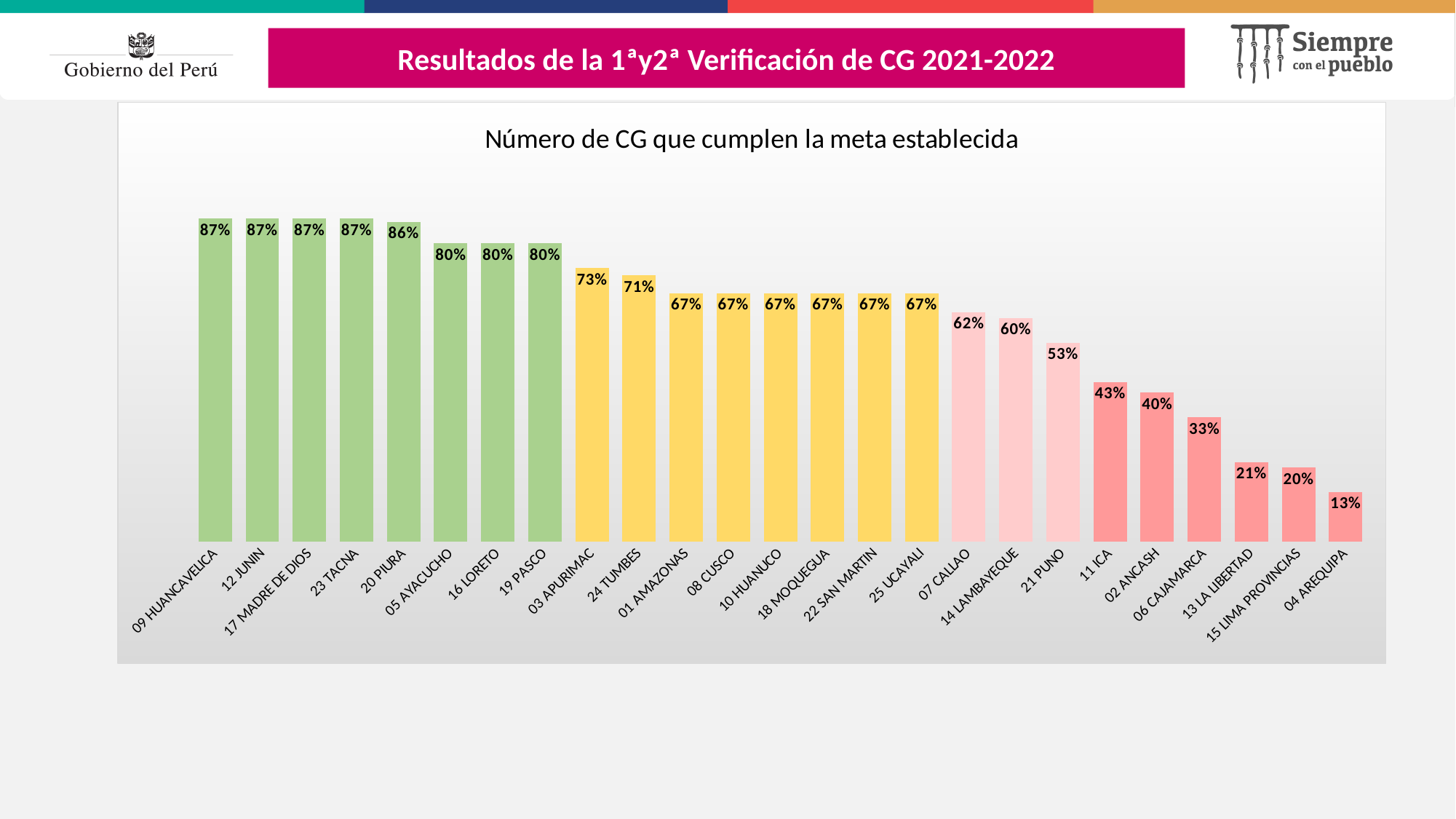
What is the value for 21 PUNO? 53% What is the title of the chart? Número de CG que cumplen la meta establecida What kind of chart is shown on the slide? Bar chart What is the value for 20 PIURA? 86% Do the values rise or fall from left to right along the x axis? Fall What is the value for 06 CAJAMARCA? 33% What is the difference between the values for 09 HUANCAVELICA and 04 AREQUIPA? 74% Which category has the lowest value? 04 AREQUIPA How many categories are shown on the x axis? 25 What is the difference between the values for 24 TUMBES and 07 CALLAO? 9% Which is larger, the value for 11 ICA or the value for 02 ANCASH? 11 ICA What is the value for 03 APURIMAC? 73%